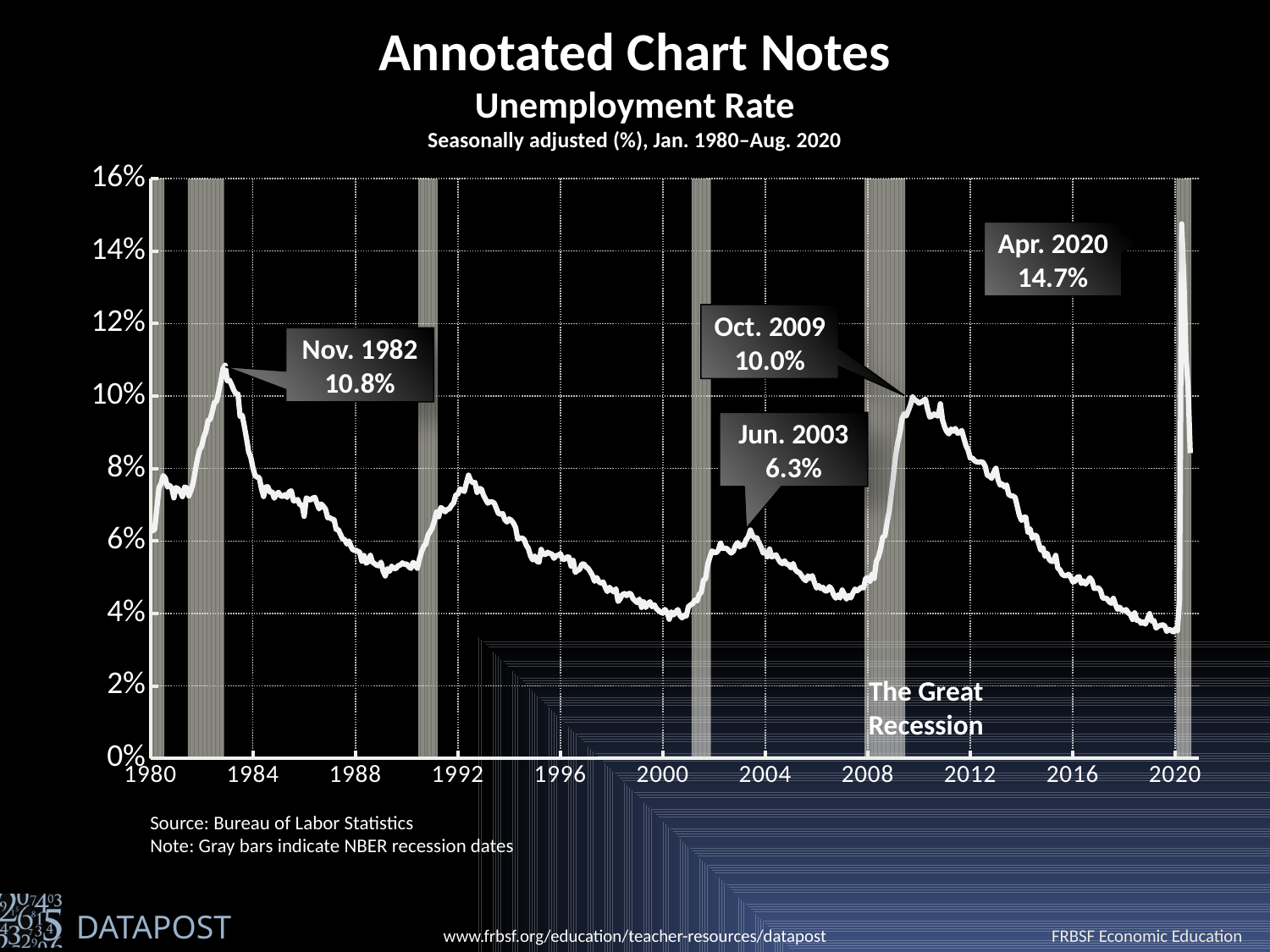
What is the unemployment rate annotated for Jun. 2003? 6.3% What is the difference between the annotated unemployment rates for Apr. 2020 and Nov. 1982? 3.9% What is the unemployment rate annotated for Nov. 1982? 10.8% What kind of chart is shown on the slide? line chart Does the unemployment rate rise or fall between 2010 and 2019? fall Is the unemployment rate in 2000 greater or less than 6%? less According to the note, what do the gray bars on the chart indicate? NBER recession dates Which annotated date has the highest unemployment rate? Apr. 2020 What is the unemployment rate annotated for Oct. 2009? 10.0% Which annotated date has the lowest unemployment rate? Jun. 2003 Which is larger, the annotated unemployment rate for Nov. 1982 or for Oct. 2009? Nov. 1982 What is the unemployment rate annotated for Apr. 2020? 14.7%